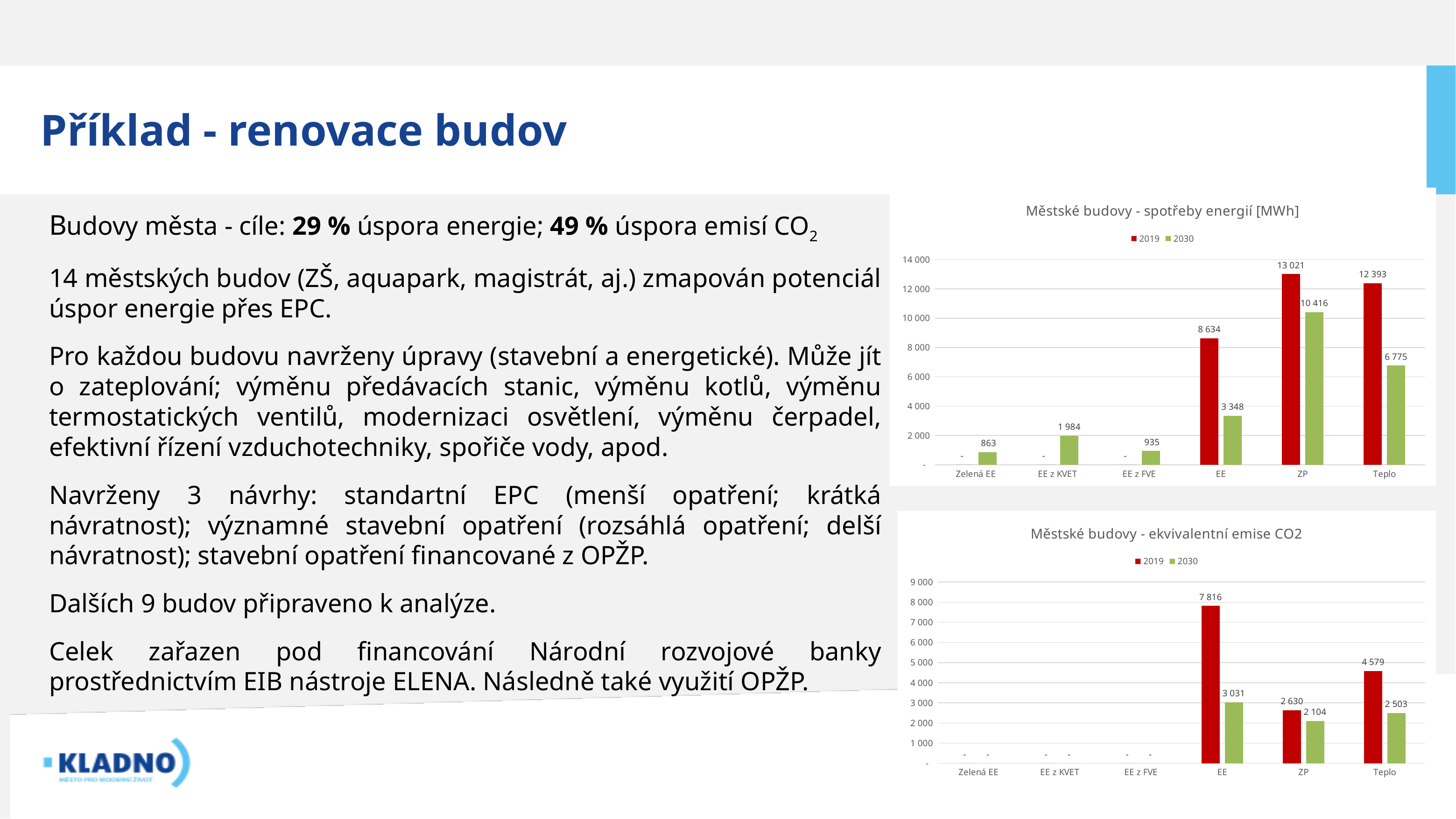
What type of chart is 'Městské budovy - spotřeby energií [MWh]'? Bar chart In the chart 'Městské budovy - ekvivalentní emise CO2', what is the 2019 value for EE? 7 816 In the chart 'Městské budovy - spotřeby energií [MWh]', what is the 2019 value for ZP? 13 021 In the chart 'Městské budovy - spotřeby energií [MWh]', which is larger for 2030: EE z KVET or EE z FVE? EE z KVET In the chart 'Městské budovy - spotřeby energií [MWh]', what is the 2030 value for Teplo? 6 775 In the chart 'Městské budovy - spotřeby energií [MWh]', which category has the highest 2030 value? ZP In the chart 'Městské budovy - ekvivalentní emise CO2', what is the 2030 value for ZP? 2 104 In the chart 'Městské budovy - spotřeby energií [MWh]', how many categories are shown on the x axis? 6 How many series does the legend of the chart 'Městské budovy - ekvivalentní emise CO2' list? 2 In the chart 'Městské budovy - ekvivalentní emise CO2', what is the difference between the 2019 and 2030 values for Teplo? 2 076 In the chart 'Městské budovy - spotřeby energií [MWh]', what is the difference between the 2019 and 2030 values for EE? 5 286 In the chart 'Městské budovy - ekvivalentní emise CO2', which category has the lowest 2030 value among EE, ZP and Teplo? ZP